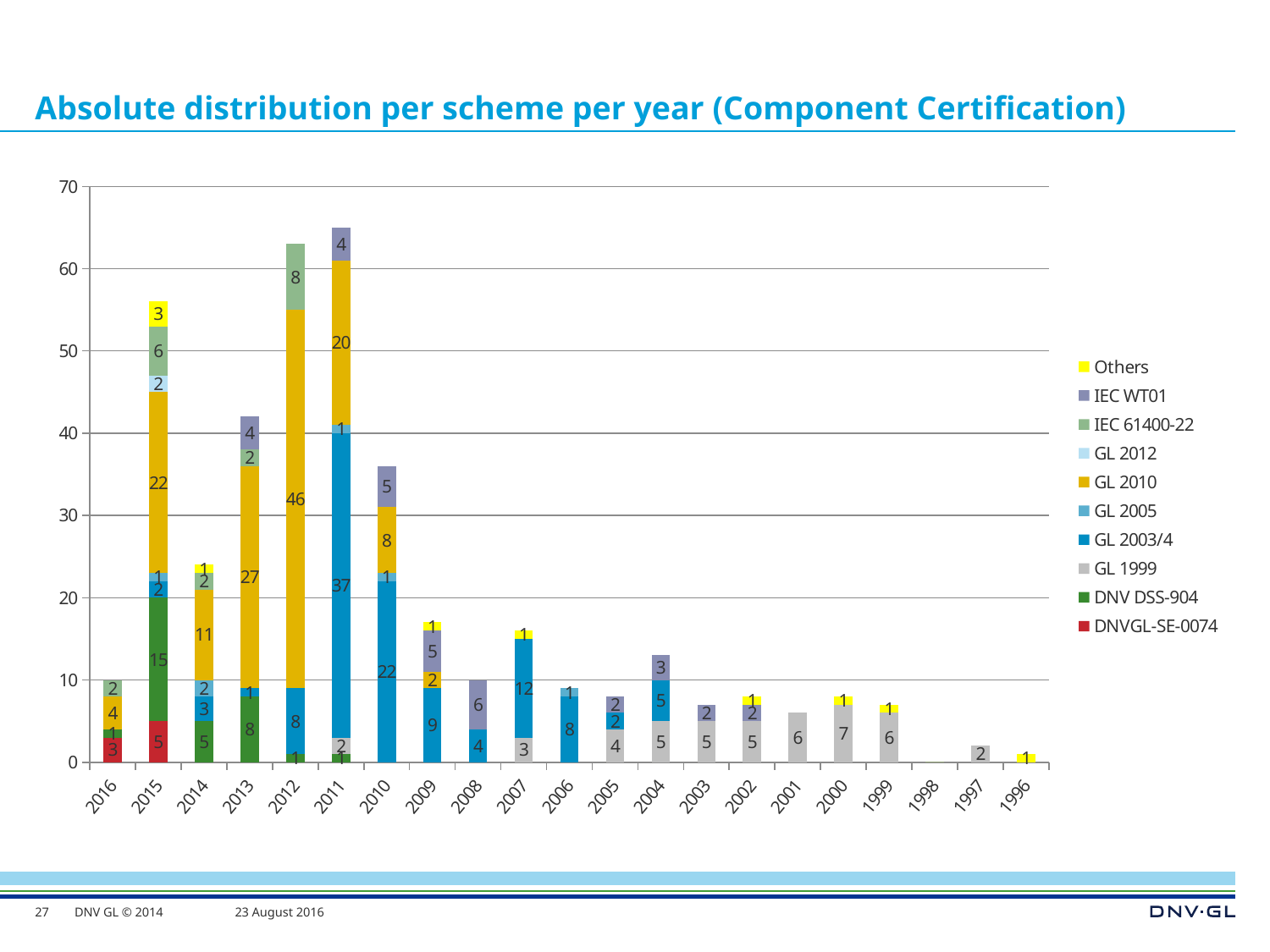
What is the value for GL 1999 in 2001? 6 What kind of chart is shown on the slide? Stacked bar chart What is the total of the stacked bar for 2008? 10 Which year has the tallest stacked bar? 2011 What is the total of the stacked bar for 2016? 10 How many series does the legend list? 10 What is the value for GL 2010 in 2012? 46 Which year has the larger GL 2010 value, 2015 or 2014? 2015 Is the total for the 2015 bar greater or less than 50? greater What is the value for GL 2003/4 in 2011? 37 How many years are shown on the x axis? 21 What is the difference between the GL 2010 value in 2012 and in 2013? 19